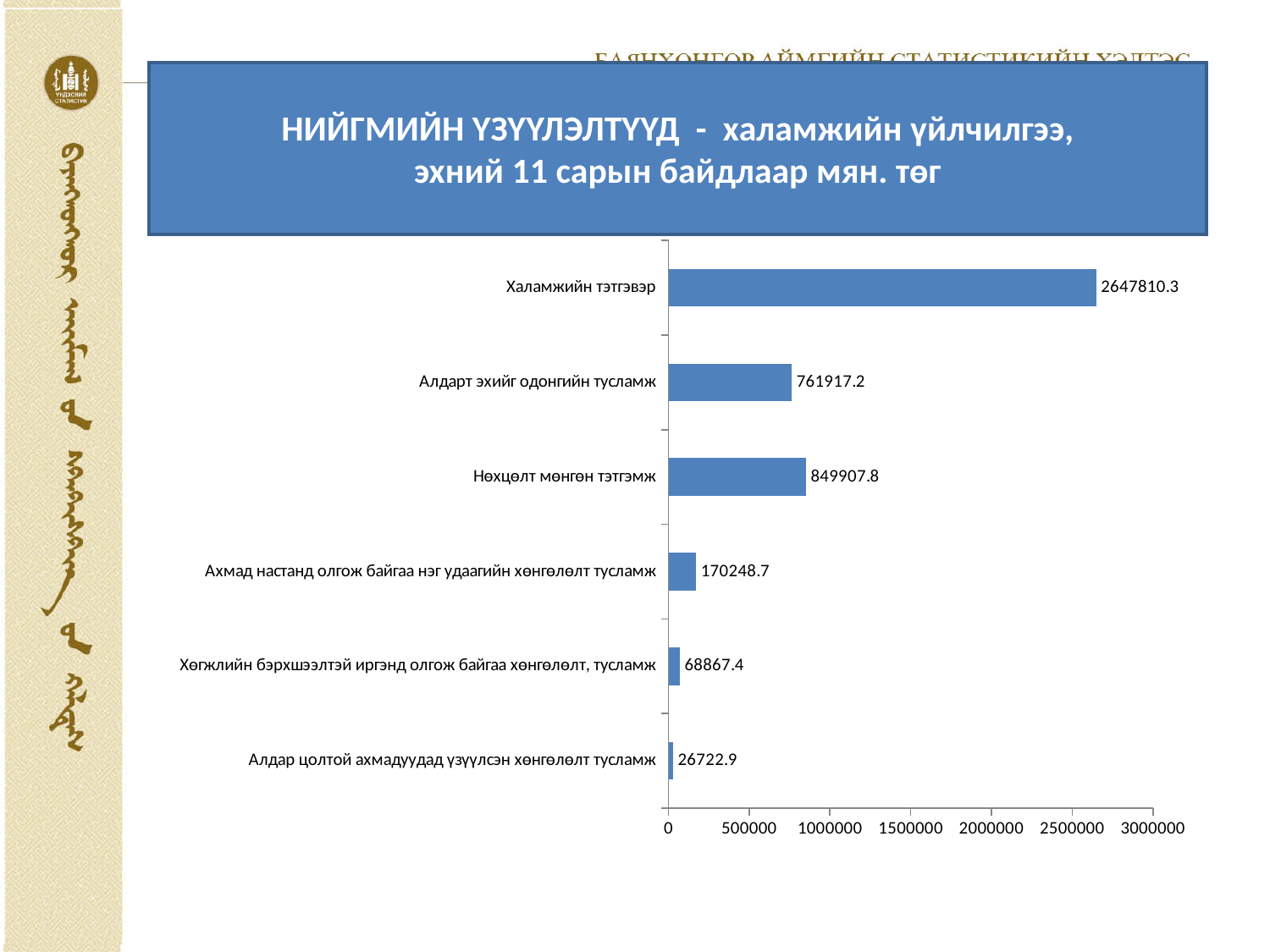
What is the value for Нөхцөлт мөнгөн тэтгэмж? 849907.8 Is the value for Халамжийн тэтгэвэр greater or less than 2500000? greater Which category has the highest value? Халамжийн тэтгэвэр What is the value for Хөгжлийн бэрхшээлтэй иргэнд олгож байгаа хөнгөлөлт, тусламж? 68867.4 What is the value for Халамжийн тэтгэвэр? 2647810.3 What is the value for Алдарт эхийг одонгийн тусламж? 761917.2 What is the difference between the values for Нөхцөлт мөнгөн тэтгэмж and Алдарт эхийг одонгийн тусламж? 87990.6 Which is larger: the value for Нөхцөлт мөнгөн тэтгэмж or the value for Алдарт эхийг одонгийн тусламж? Нөхцөлт мөнгөн тэтгэмж How many categories are shown in the chart? 6 What kind of chart is shown on the slide? bar chart What is the difference between the values for Ахмад настанд олгож байгаа нэг удаагийн хөнгөлөлт тусламж and Хөгжлийн бэрхшээлтэй иргэнд олгож байгаа хөнгөлөлт, тусламж? 101381.3 Which category has the lowest value? Алдар цолтой ахмадуудад үзүүлсэн хөнгөлөлт тусламж